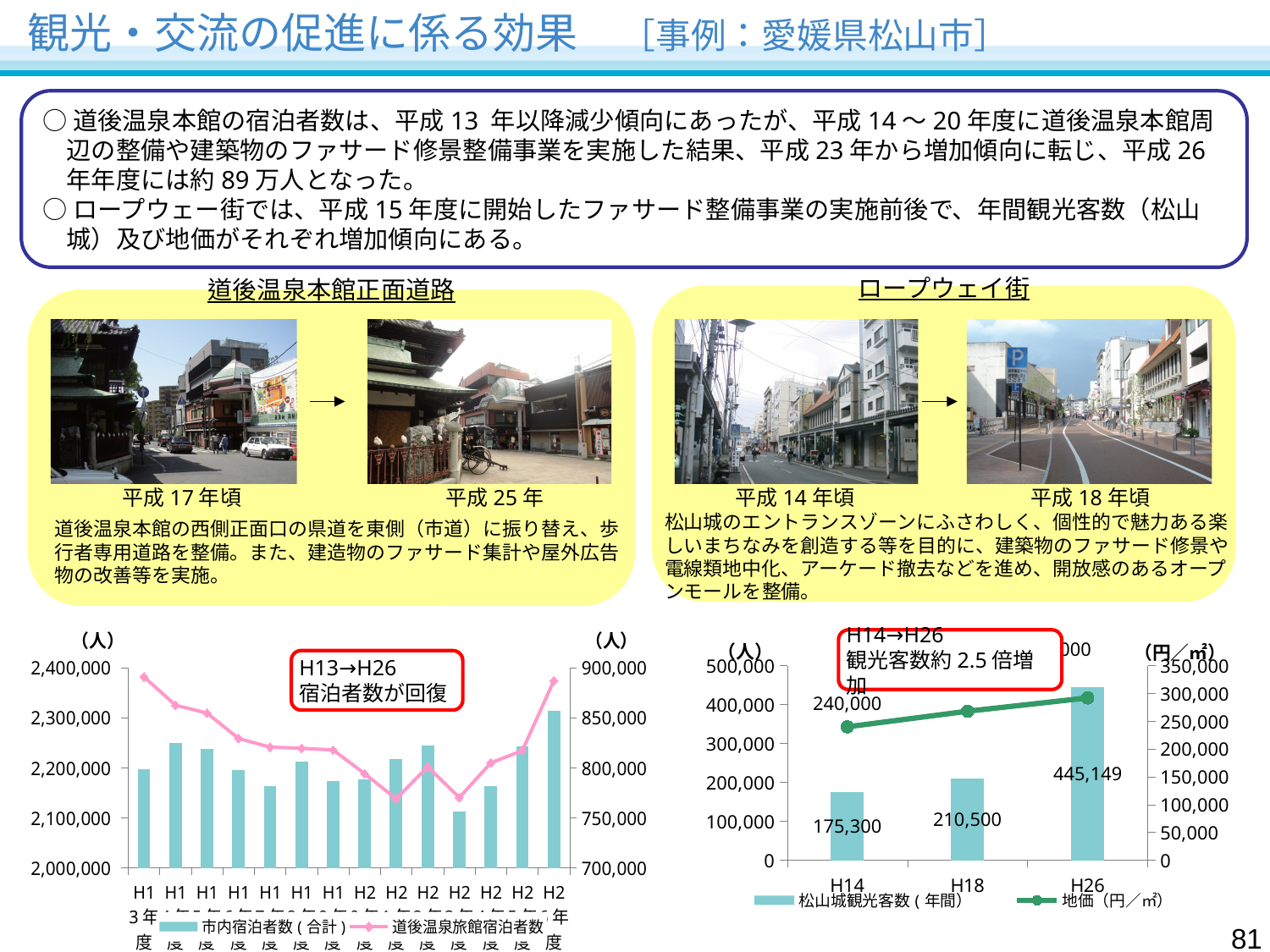
In the chart on the right, what is the value of 松山城観光客数 for H26? 445,149 In the chart on the right, which year has the highest 松山城観光客数? H26 In the chart on the right, what is the difference in 松山城観光客数 between H26 and H14? 269,849 How many series does the legend of the chart on the left list? 2 In the chart on the right, what is the value of 松山城観光客数 for H14? 175,300 In the chart on the right, how many years are shown on the x axis? 3 In the chart on the right, what is the value of 松山城観光客数 for H18? 210,500 In the chart on the right, what is the difference in 松山城観光客数 between H18 and H14? 35,200 In the chart on the right, does 松山城観光客数 rise or fall from H14 to H26? rise In the chart on the right, what is the 地価 value for H14? 240,000 What kind of chart is the chart on the left? Combined bar and line chart In the chart on the right, which year has the lowest 松山城観光客数? H14